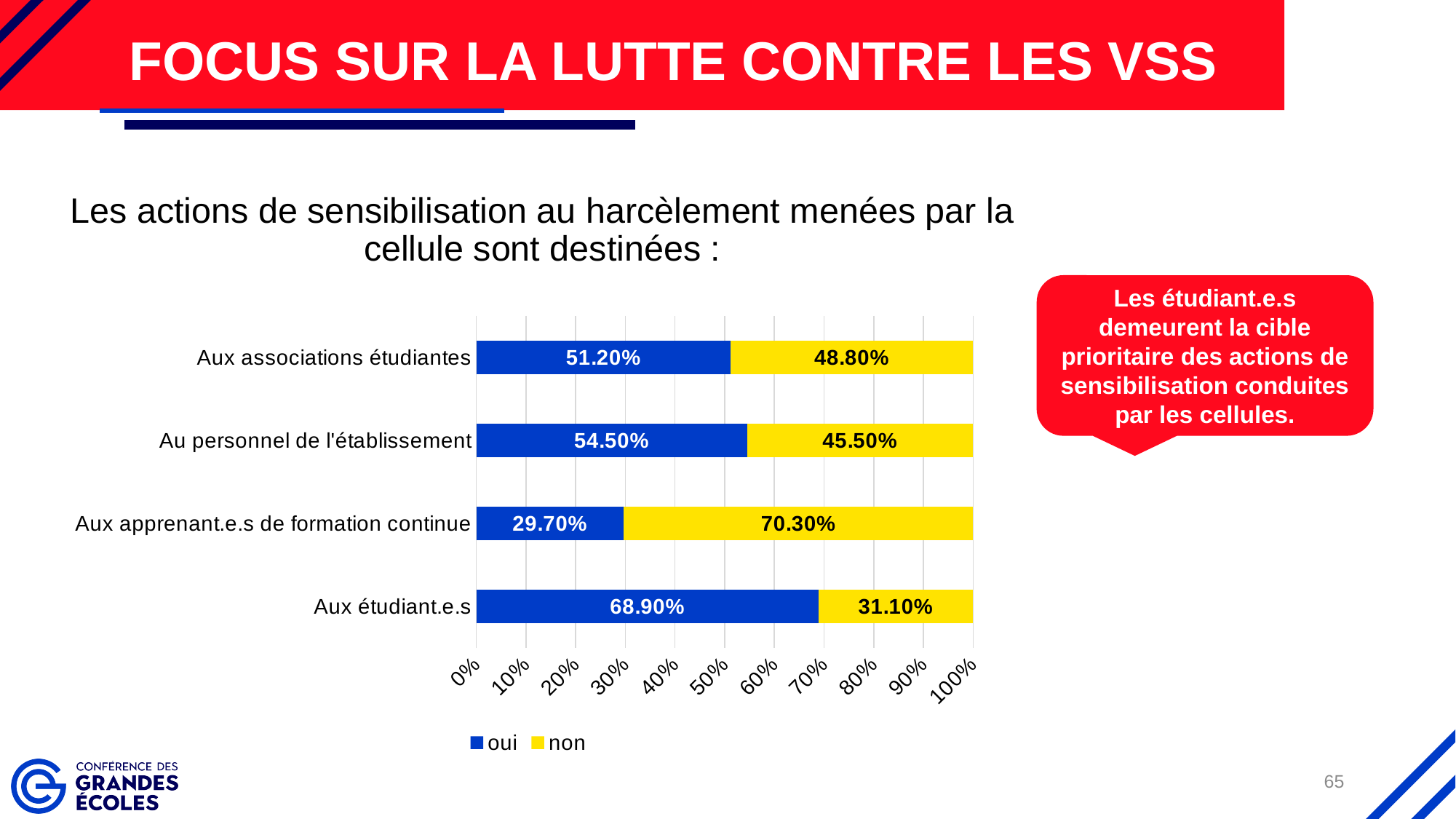
How many series does the legend list? 2 Which category has the lowest 'oui' value? Aux apprenant.e.s de formation continue What kind of chart is shown on the slide? Stacked bar chart What is the 'non' value for 'Aux apprenant.e.s de formation continue'? 70.30% What is the 'oui' value for 'Aux étudiant.e.s'? 68.90% What is the 'oui' value for 'Au personnel de l'établissement'? 54.50% What colour represents the 'non' series in the chart? Yellow What is the difference between the 'oui' values for 'Aux étudiant.e.s' and 'Aux apprenant.e.s de formation continue'? 39.20% How many categories are shown in the chart? 4 Which is larger: the 'oui' value for 'Au personnel de l'établissement' or the 'oui' value for 'Aux associations étudiantes'? Au personnel de l'établissement Which category has the highest 'oui' value? Aux étudiant.e.s What is the 'non' value for 'Aux associations étudiantes'? 48.80%